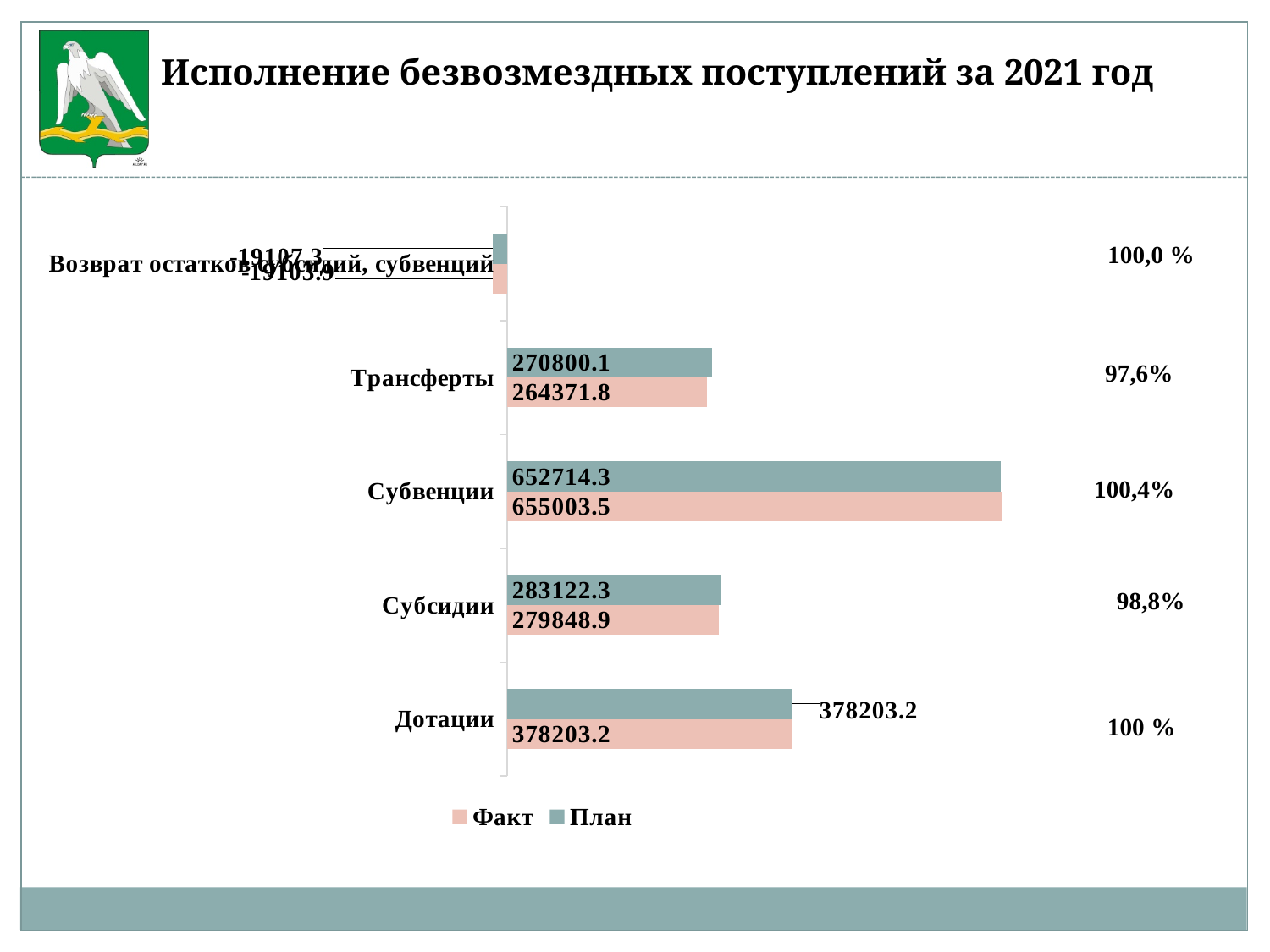
What is the План value for Дотации? 378203.2 What is the Факт value for Субсидии? 279848.9 Which is larger for Субсидии, the План value or the Факт value? План What is the Факт value for Субвенции? 655003.5 How many categories are shown on the chart? 5 What is the difference between the План and Факт values for Трансферты? 6428.3 Which category has the highest Факт value? Субвенции How many series does the legend list? 2 What is the difference between the Факт and План values for Субвенции? 2289.2 What is the План value for Трансферты? 270800.1 What percentage is shown next to the Трансферты bars? 97,6% What type of chart is shown on the slide? bar chart